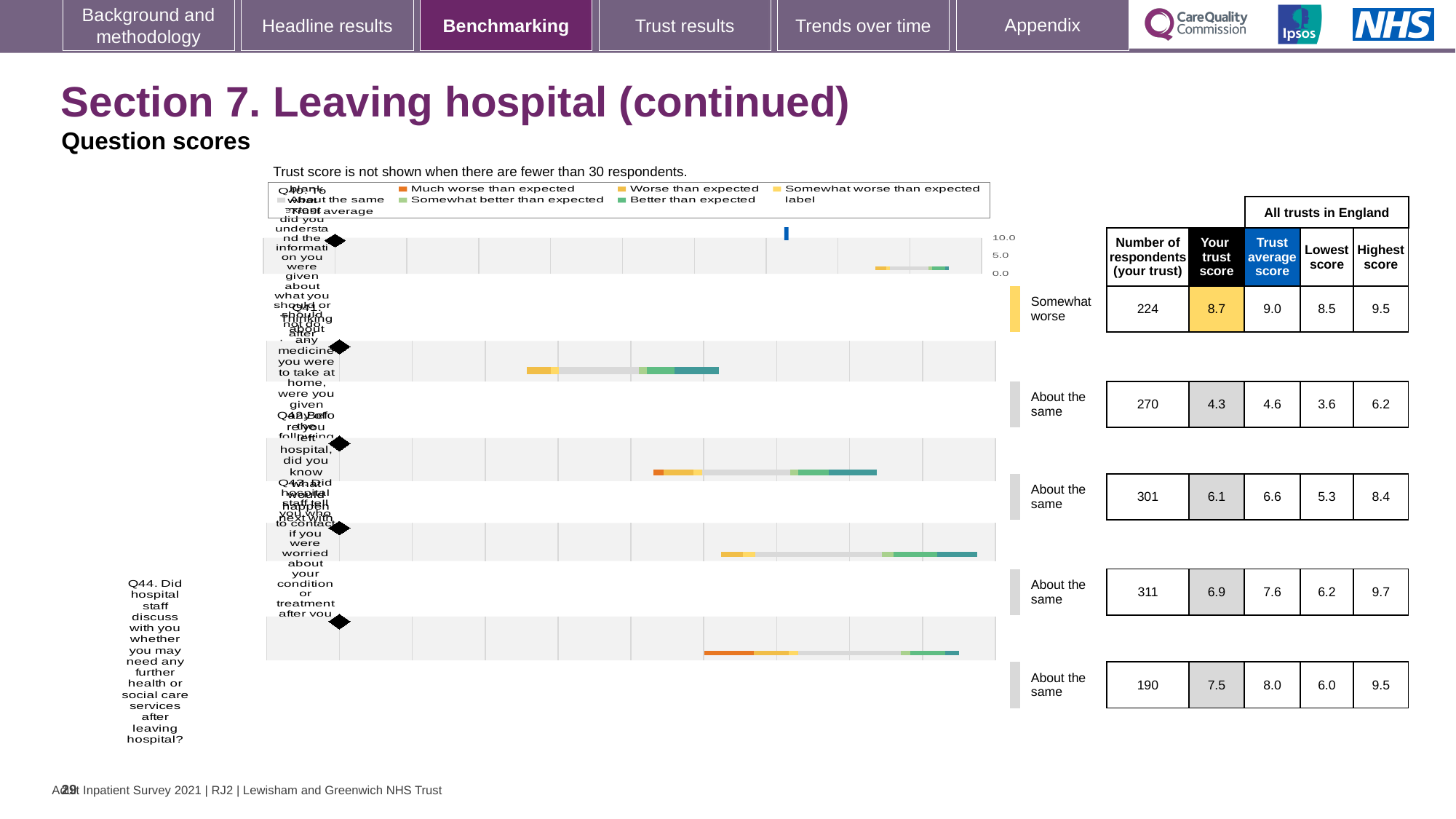
What is the difference between the trust average score and your trust score for Q44? 0.5 Which question row is rated 'Somewhat worse' than expected? The first row (Q40) What kind of chart is used to show the question scores on this slide? bar chart Which question row has the lowest 'Your trust score' in the chart? The second row (Q41), 4.3 What is the 'Your trust score' value for Q44 (discussing whether you may need further health or social care services after leaving hospital)? 7.5 For the first question row (Q40), which is larger: your trust score or the trust average score? Trust average score (9.0) How many question rows are rated 'About the same'? 4 How many respondents from the trust answered Q44? 190 How many question rows are plotted in the question scores chart? 5 Is your trust score for Q44 greater or less than 5.0? greater What is the 'Trust average score' for Q44? 8.0 Which question row has the highest 'Your trust score' in the chart? The first row (Q40), 8.7